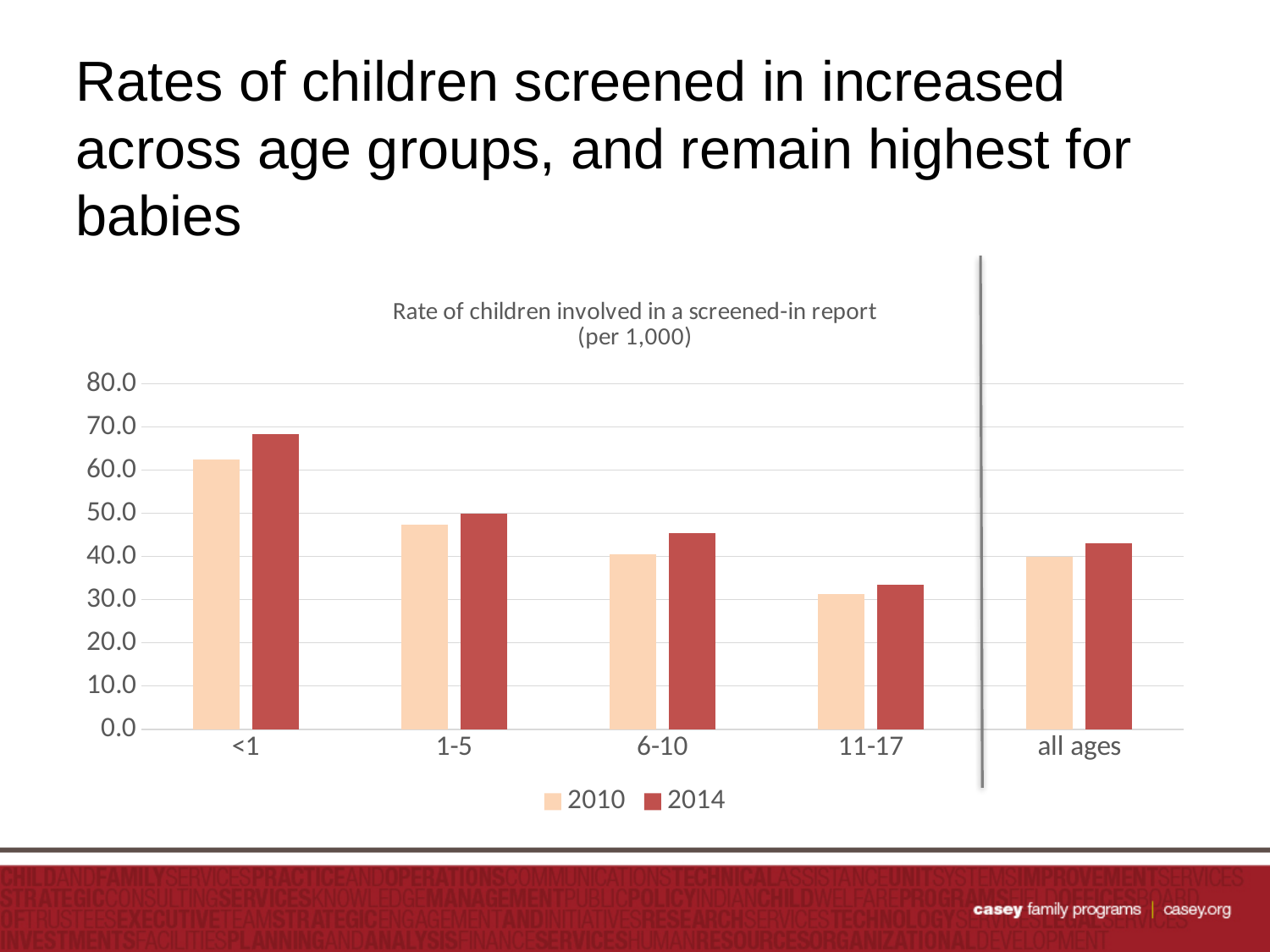
What is the title of the chart? Rate of children involved in a screened-in report (per 1,000) How many categories are shown on the x axis? 5 Which age group has the lowest 2010 rate? 11-17 Is the 2010 value for the 11-17 age group greater or less than 40? less What kind of chart is shown on the slide? bar chart Moving from the <1 age group to the 11-17 age group, do the 2014 values rise or fall? fall Is the 2014 value for the 11-17 age group greater or less than 40? less Which is larger: the 2014 value for <1 or the 2014 value for 1-5? <1 How many series does the legend list? 2 Is the 2010 value for the <1 age group greater or less than 60? greater Which age group has the highest 2014 rate? <1